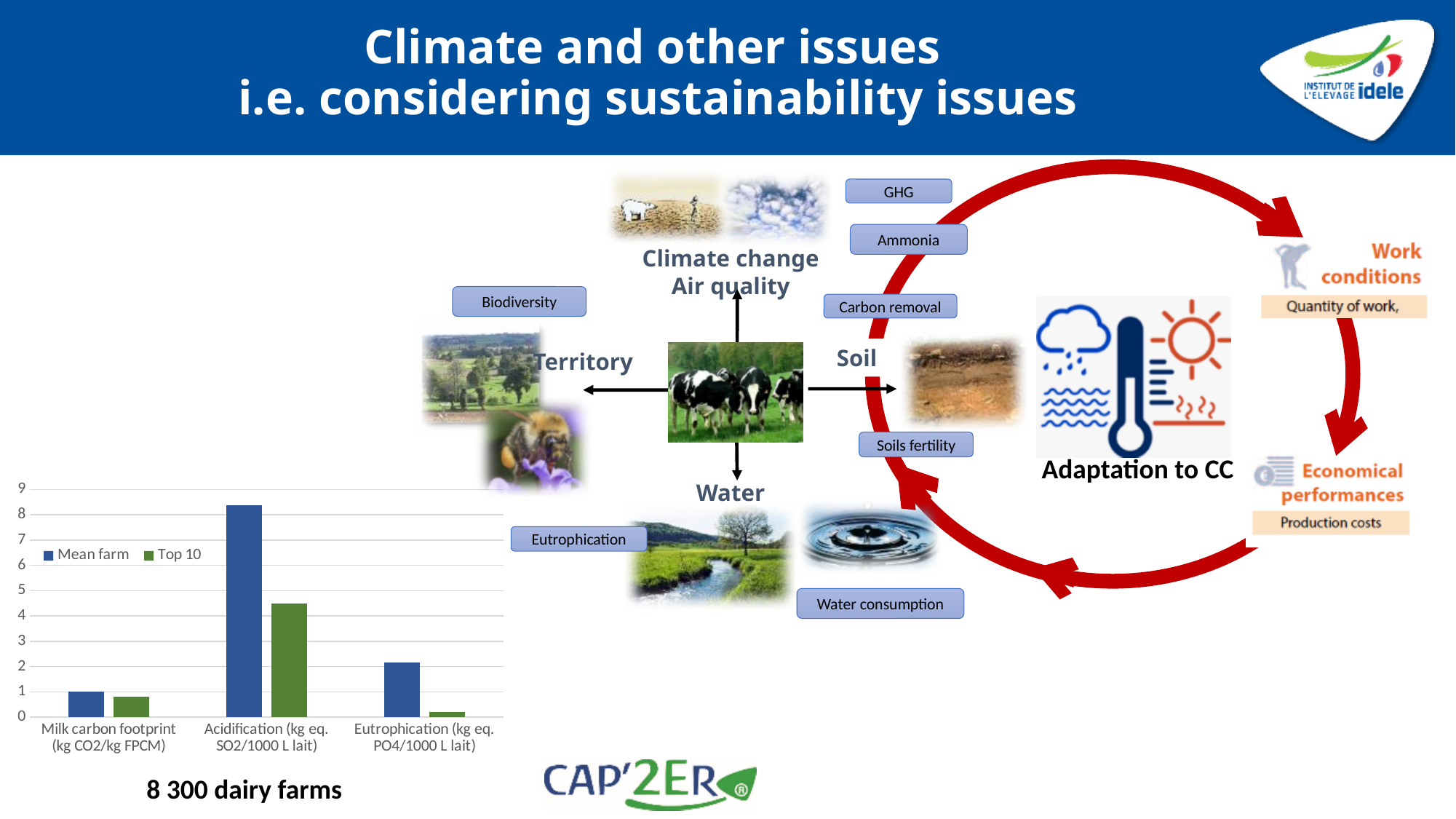
Which category has the lowest Top 10 value in the bar chart? Eutrophication (kg eq. PO4/1000 L lait) What kind of chart is shown at the bottom left of the slide? bar chart What are the two series names listed in the legend of the bar chart? Mean farm and Top 10 For Acidification, which series has the larger value: Mean farm or Top 10? Mean farm How many categories are shown on the x axis of the bar chart? 3 How many series does the legend of the bar chart list? 2 Is the Mean farm value for Eutrophication greater or less than 3? less For Milk carbon footprint, which series has the larger value: Mean farm or Top 10? Mean farm Is the Top 10 value for Acidification greater or less than 5? less Is the Mean farm value for Acidification greater or less than 8? greater Which category has the highest Mean farm value in the bar chart? Acidification (kg eq. SO2/1000 L lait)